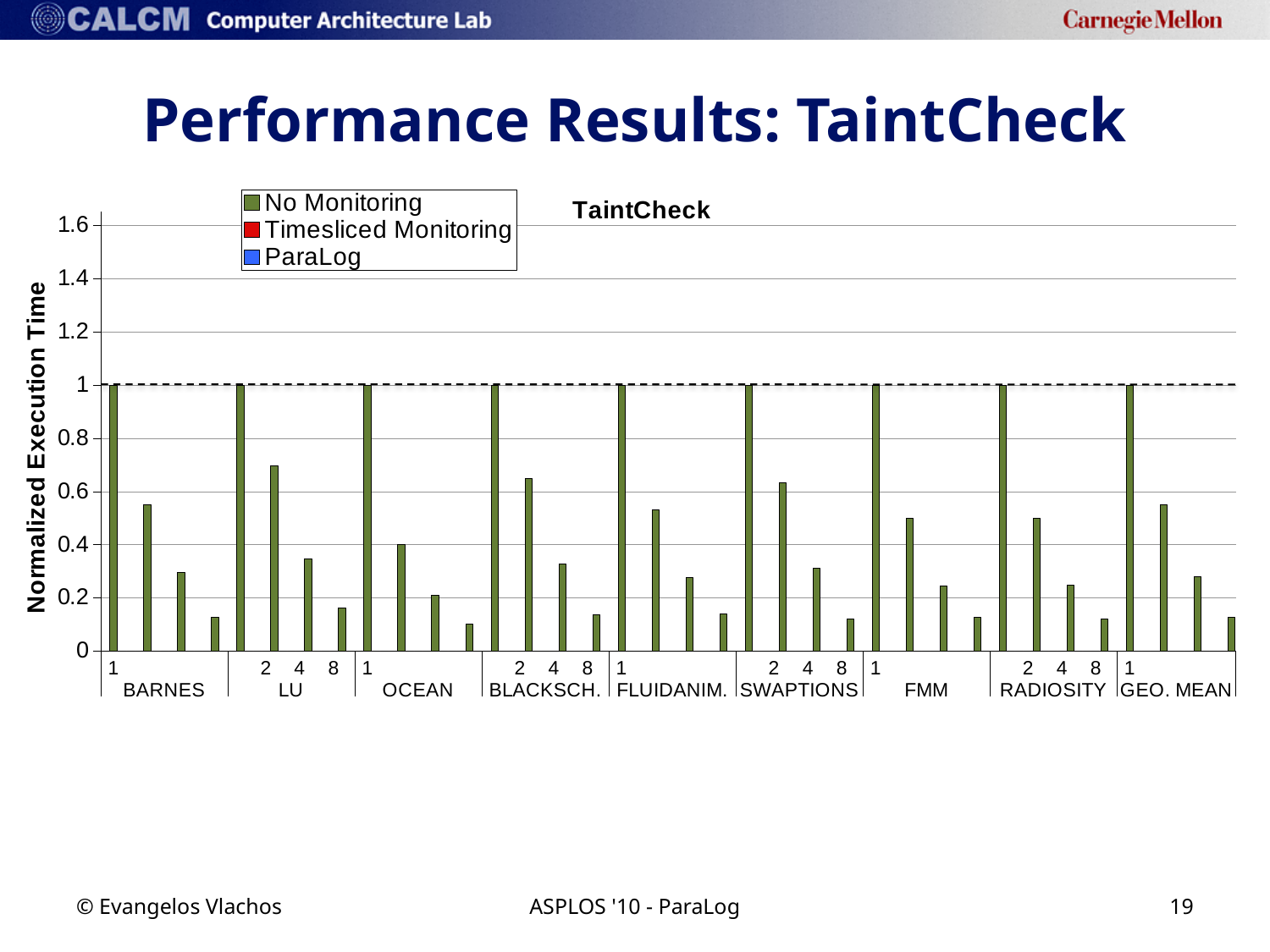
How many series does the legend list? 3 What is the normalized execution time for GEO. MEAN with 1 core? 1 Within each benchmark group, do the values rise or fall as the core count increases from 1 to 8? fall Is the value for OCEAN with 8 cores greater or less than 0.2? less How many benchmark groups are shown along the x axis? 9 What kind of chart is shown on the slide? bar chart Is the value for BARNES with 8 cores greater or less than 0.2? less Is the value for BARNES with 2 cores greater or less than 0.4? greater Which is larger, the value for LU with 2 cores or the value for OCEAN with 2 cores? LU with 2 cores What is the normalized execution time for BARNES with 1 core? 1 What is the label on the y axis of the chart? Normalized Execution Time